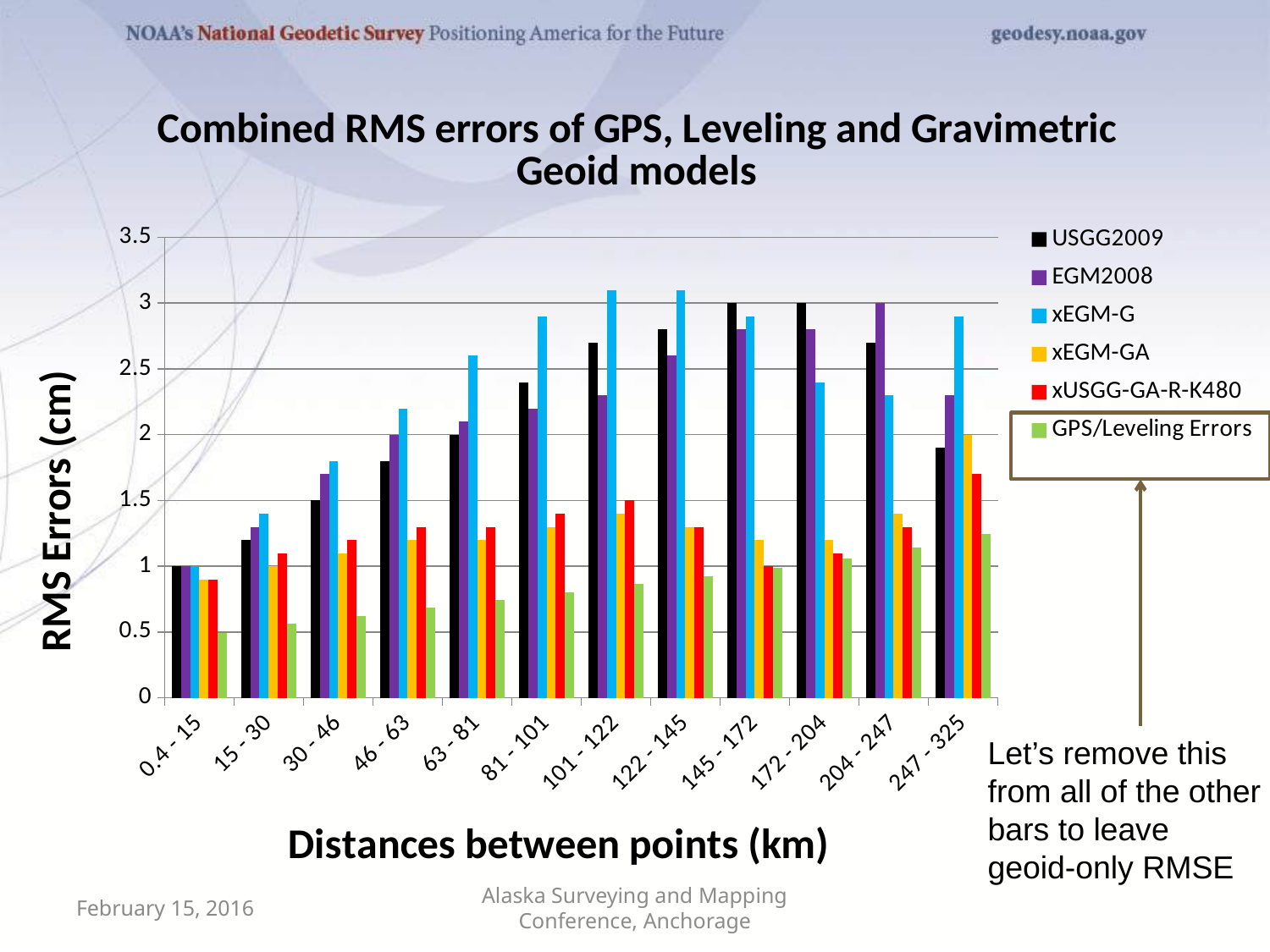
What is the title of the y axis? RMS Errors (cm) Is the xEGM-G value for the 101 - 122 km category greater or less than 2.5? greater Is the GPS/Leveling Errors value for the 0.4 - 15 km category greater or less than 1? less Is the USGG2009 value for the 145 - 172 km category greater or less than 2.5? greater Which distance category has the highest xEGM-GA value? 247 - 325 How many distance categories are shown on the x axis? 12 Which series has the highest value in the 101 - 122 km category? xEGM-G Do the GPS/Leveling Errors values generally rise or fall as distance between points increases? rise In the 145 - 172 km category, which is larger: USGG2009 or xEGM-GA? USGG2009 How many series does the legend list? 6 What kind of chart is shown on the slide? bar chart Which series has the lowest value in the 0.4 - 15 km category? GPS/Leveling Errors